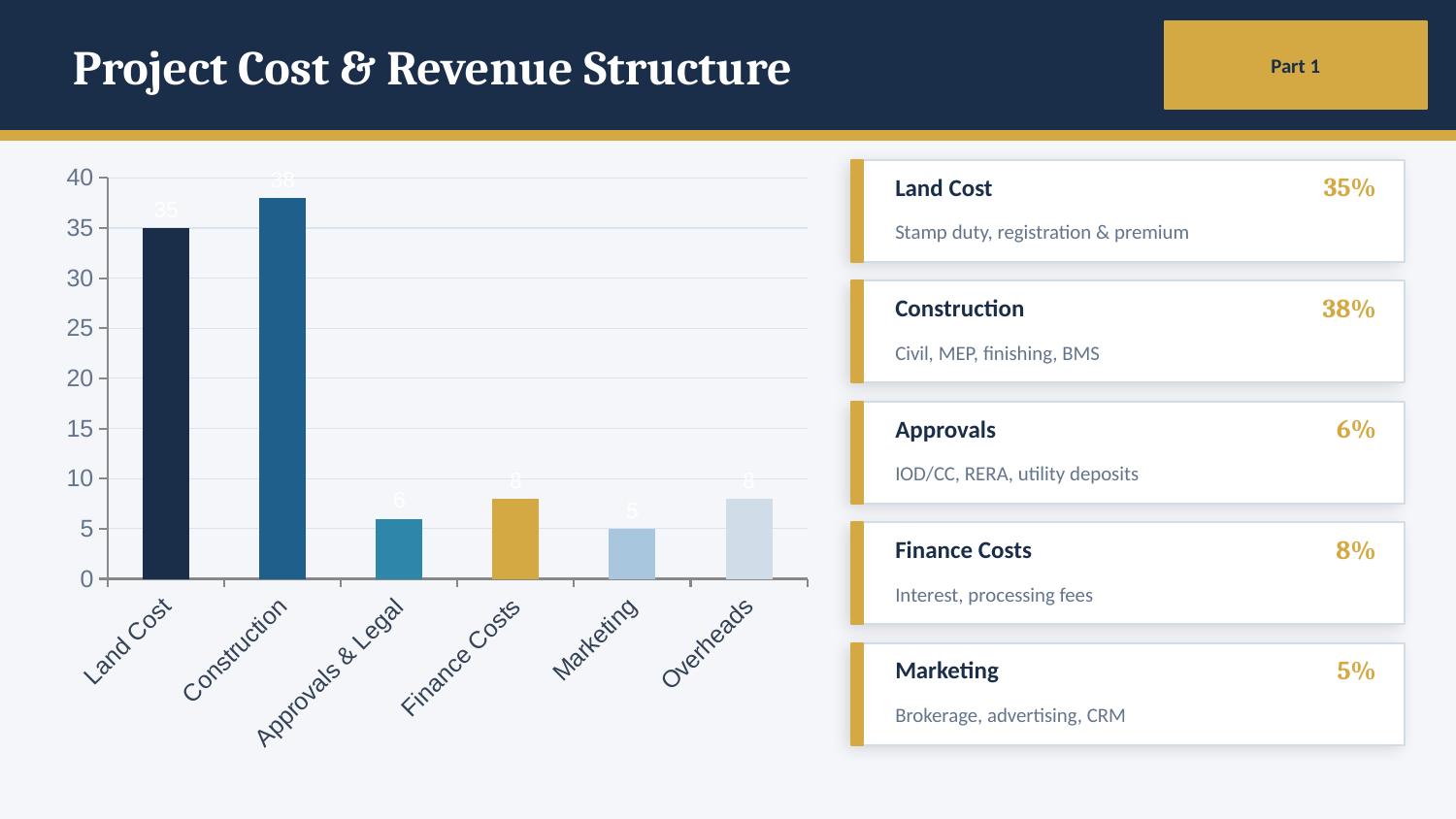
Is the value for Land Cost greater or less than 30? greater Which is larger, the value for Finance Costs or the value for Approvals & Legal? Finance Costs What is the value for Marketing in the bar chart? 5 Which category has the highest value in the bar chart? Construction What is the value for Construction in the bar chart? 38 What is the difference between the values for Finance Costs and Marketing? 3 What is the difference between the values for Construction and Land Cost? 3 Which category has the lowest value in the bar chart? Marketing What is the value for Land Cost in the bar chart? 35 How many categories are plotted in the bar chart? 6 What type of chart is shown on the slide? Bar chart What is the value for Overheads in the bar chart? 8